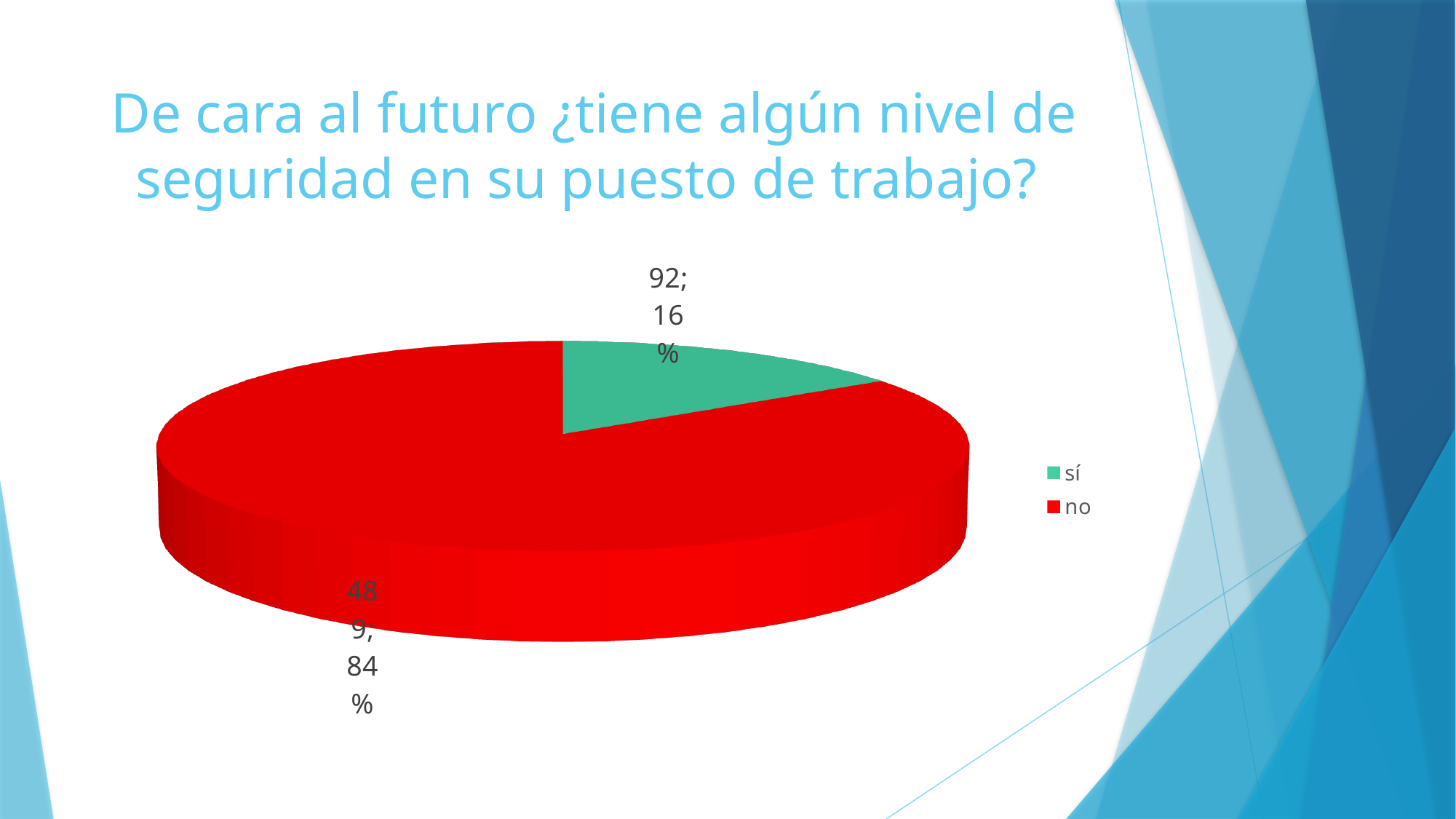
Which slice is the smallest? sí What is the difference between the counts for "no" and "sí"? 397 What percentage of the pie does the "sí" slice represent? 16% What is the count shown for the "no" slice? 489 How many entries does the legend list? 2 Which is larger, the "sí" slice or the "no" slice? no What percentage of the pie does the "no" slice represent? 84% How many slices does the pie chart have? 2 Which slice is the largest? no What colour is the "no" slice? red What is the count shown for the "sí" slice? 92 What kind of chart is shown on the slide? pie chart